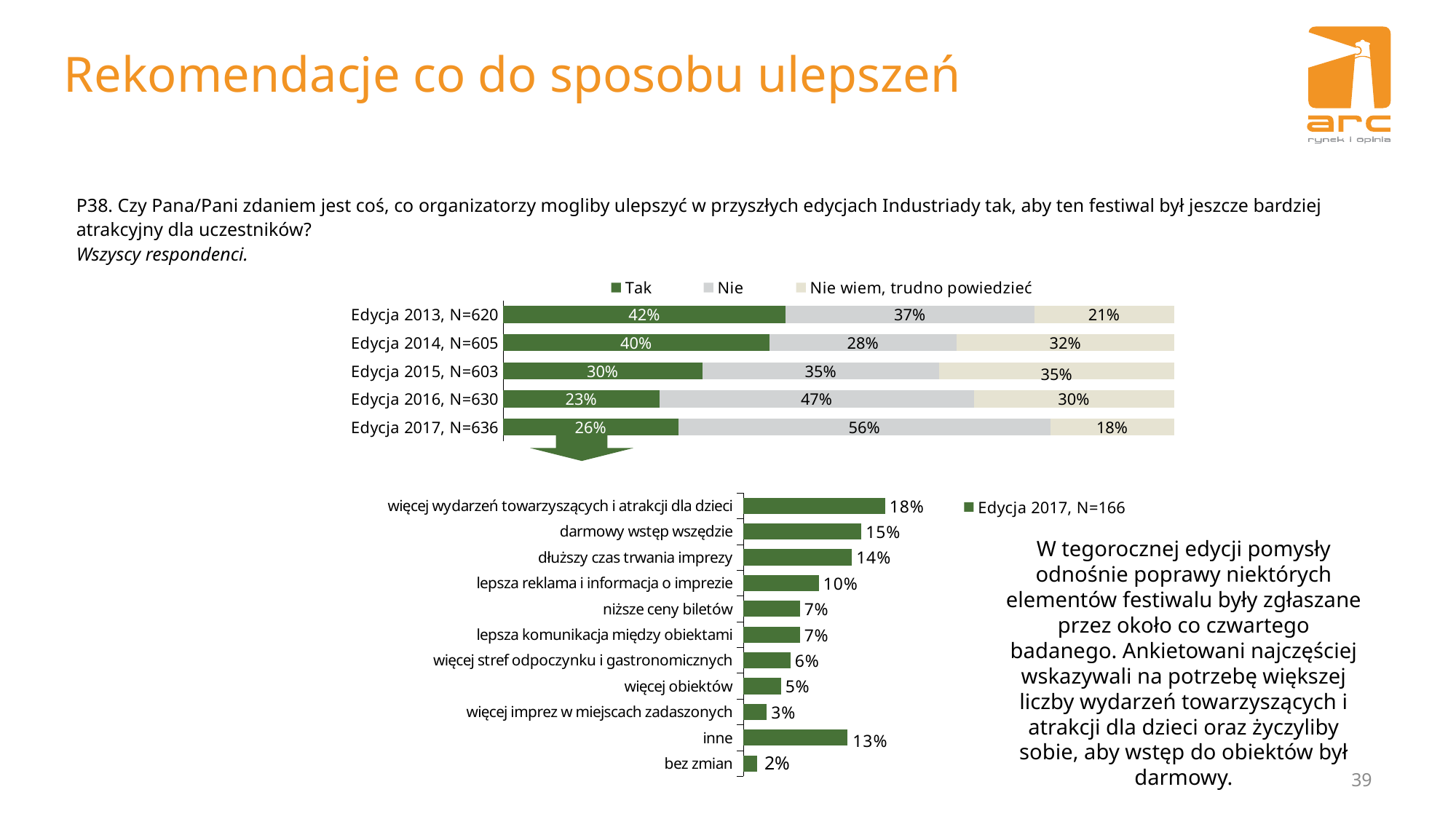
In the top stacked bar chart, what is the value of "Tak" for Edycja 2013, N=620? 42% In the bottom bar chart, what is the value for "darmowy wstęp wszędzie"? 15% In the bottom bar chart, which category has the lowest value? bez zmian In the bottom bar chart, which category has the highest value? więcej wydarzeń towarzyszących i atrakcji dla dzieci In the top stacked bar chart, does the "Tak" value rise or fall from Edycja 2013 to Edycja 2016? fall How many series does the legend of the top stacked bar chart list? 3 In the top stacked bar chart, what is the value of "Nie" for Edycja 2017, N=636? 56% In the top stacked bar chart, which edition has the lowest "Nie wiem, trudno powiedzieć" value? Edycja 2017, N=636 How many categories are shown in the bottom bar chart? 11 In the top stacked bar chart, what is the difference between the "Nie" values for Edycja 2016, N=630 and Edycja 2013, N=620? 10% In the bottom bar chart, which is larger: "inne" or "lepsza reklama i informacja o imprezie"? inne In the top stacked bar chart, which edition has the highest "Tak" value? Edycja 2013, N=620